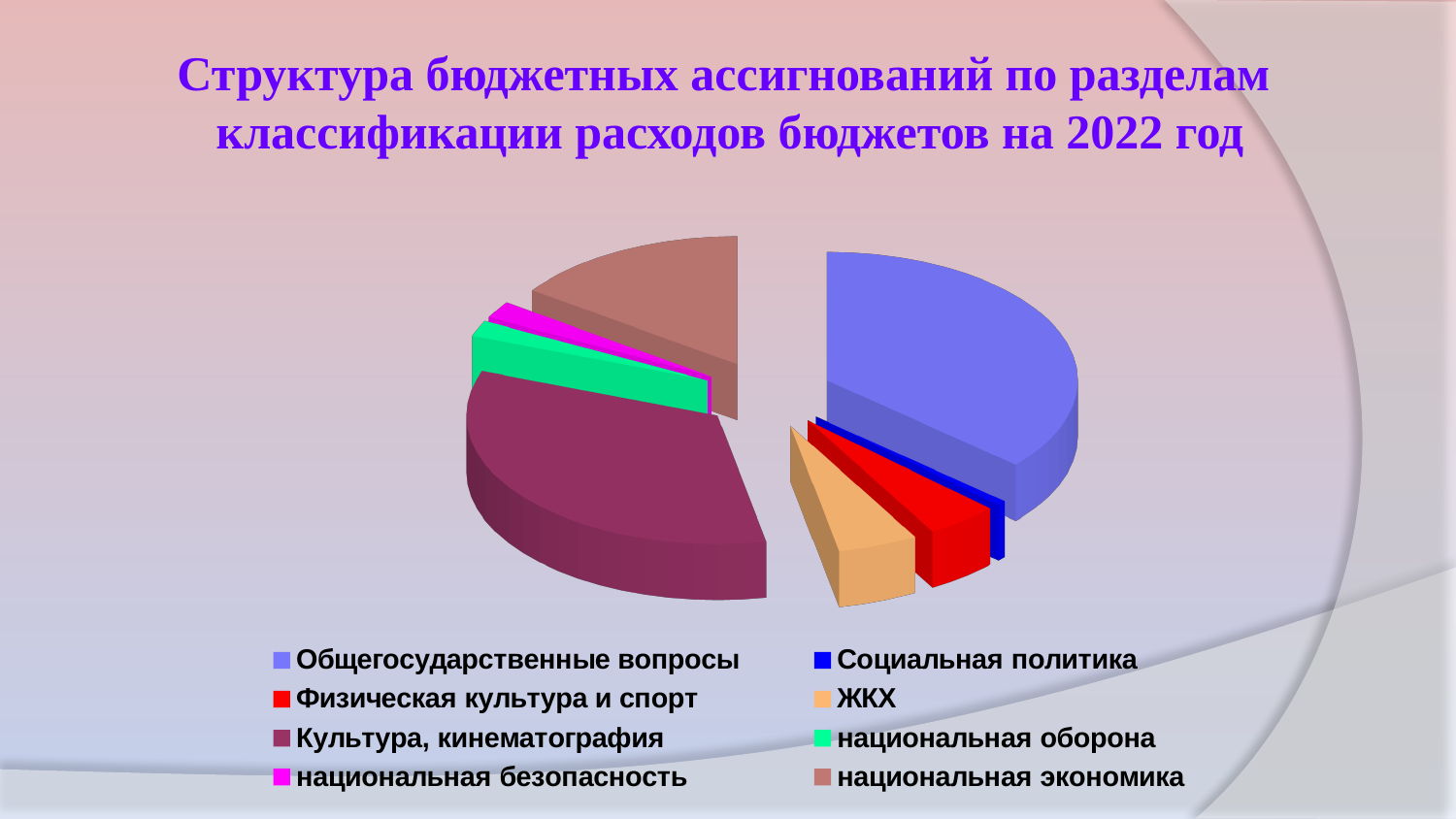
Which is larger in the pie chart: the slice for Общегосударственные вопросы or the slice for ЖКХ? Общегосударственные вопросы Which is larger in the pie chart: the slice for национальная экономика or the slice for Социальная политика? национальная экономика What is the title of the slide containing the pie chart? Структура бюджетных ассигнований по разделам классификации расходов бюджетов на 2022 год What kind of chart is shown on the slide? pie chart Which is larger in the pie chart: the slice for национальная безопасность or the slice for Общегосударственные вопросы? Общегосударственные вопросы Which category is shown in red in the pie chart's legend? Физическая культура и спорт How many categories does the pie chart's legend list? 8